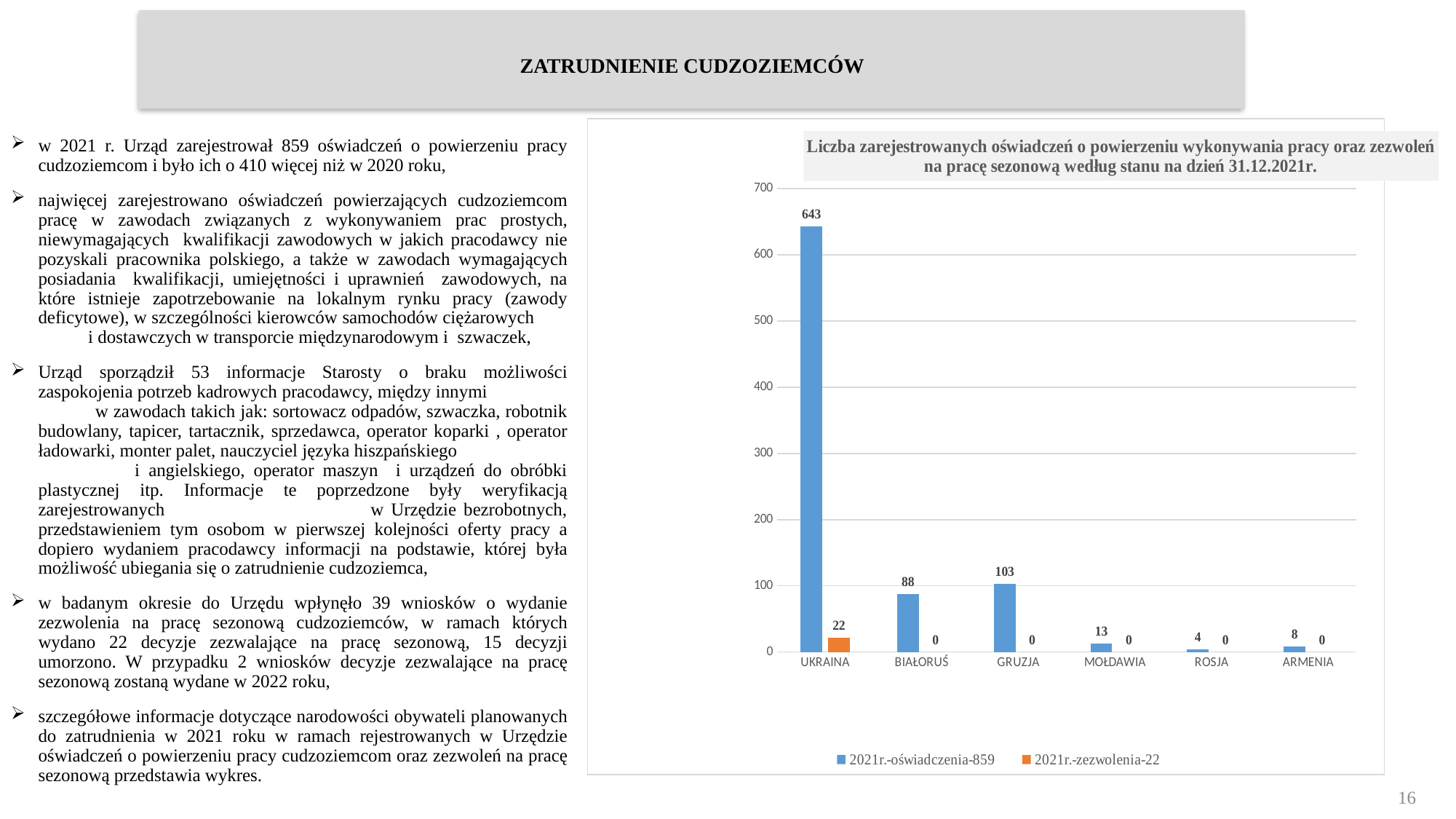
Which is larger, the 2021r.-oświadczenia-859 value for ARMENIA or for MOŁDAWIA? MOŁDAWIA Is the value of 2021r.-oświadczenia-859 for UKRAINA greater or less than 600? greater What is the value of 2021r.-zezwolenia-22 for UKRAINA? 22 What is the value of 2021r.-oświadczenia-859 for UKRAINA? 643 What is the difference between the 2021r.-oświadczenia-859 values for GRUZJA and BIAŁORUŚ? 15 What is the value of 2021r.-oświadczenia-859 for GRUZJA? 103 Which country has the highest value for 2021r.-oświadczenia-859? UKRAINA What kind of chart is shown on the slide? bar chart What is the value of 2021r.-oświadczenia-859 for MOŁDAWIA? 13 How many series does the legend list? 2 How many countries are shown on the x axis? 6 Which country has the lowest value for 2021r.-oświadczenia-859? ROSJA